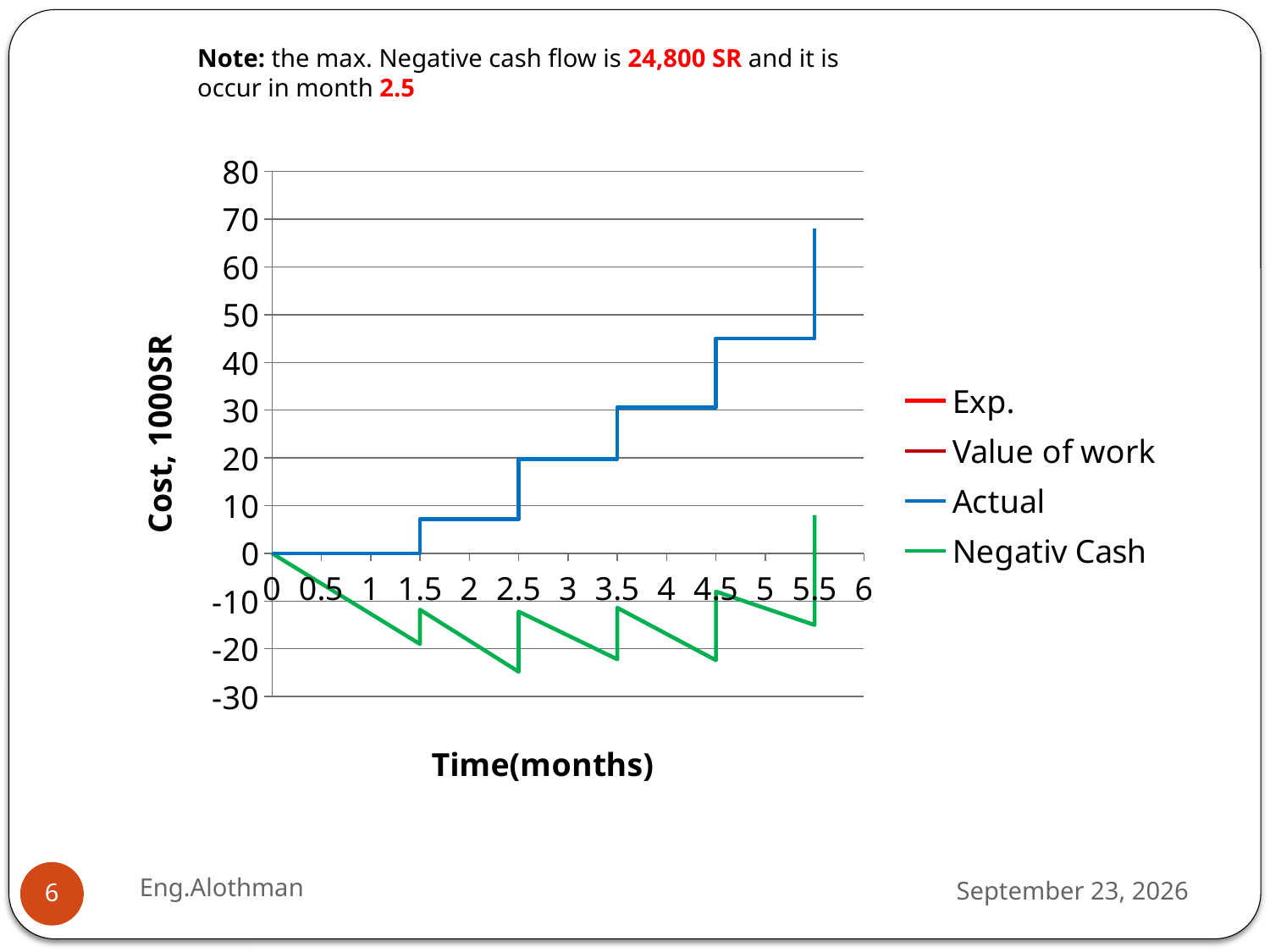
Is the lowest value of the Negativ Cash series greater or less than -20? less What is the title of the vertical axis of the chart? Cost, 1000SR At which month does the Actual series reach its highest value? 5.5 Does the Actual series rise or fall as time increases along the x axis? rise What kind of chart is shown on the slide? line chart Is the value of the Actual series at month 5.5 greater or less than 60? greater What is the title of the horizontal axis of the chart? Time(months) At which month does the Negativ Cash series reach its lowest value? 2.5 Is the value of the Actual series at month 5 greater or less than 40? greater How many series does the chart legend list? 4 At month 3, which series has the larger value, Actual or Negativ Cash? Actual